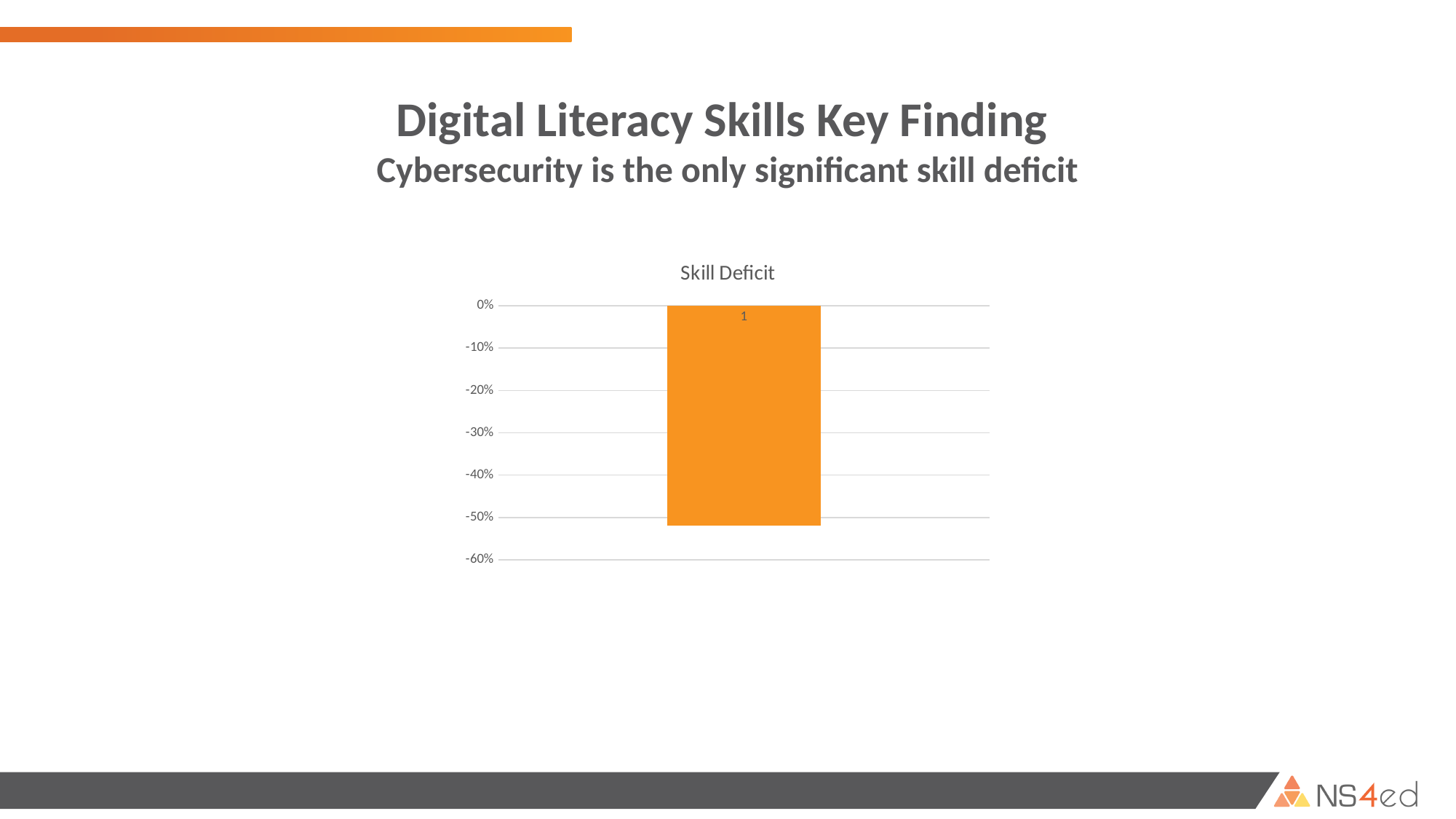
Is the value for category 1 greater or less than -40%? less Is the value for category 1 greater or less than -60%? greater What is the title of the chart? Skill Deficit How many bars are plotted in the chart? 1 What kind of chart is shown on the slide? bar chart Is the value plotted in the chart positive or negative? negative What is the lowest value shown on the vertical axis of the chart? -60% What is the category label shown on the bar in the chart? 1